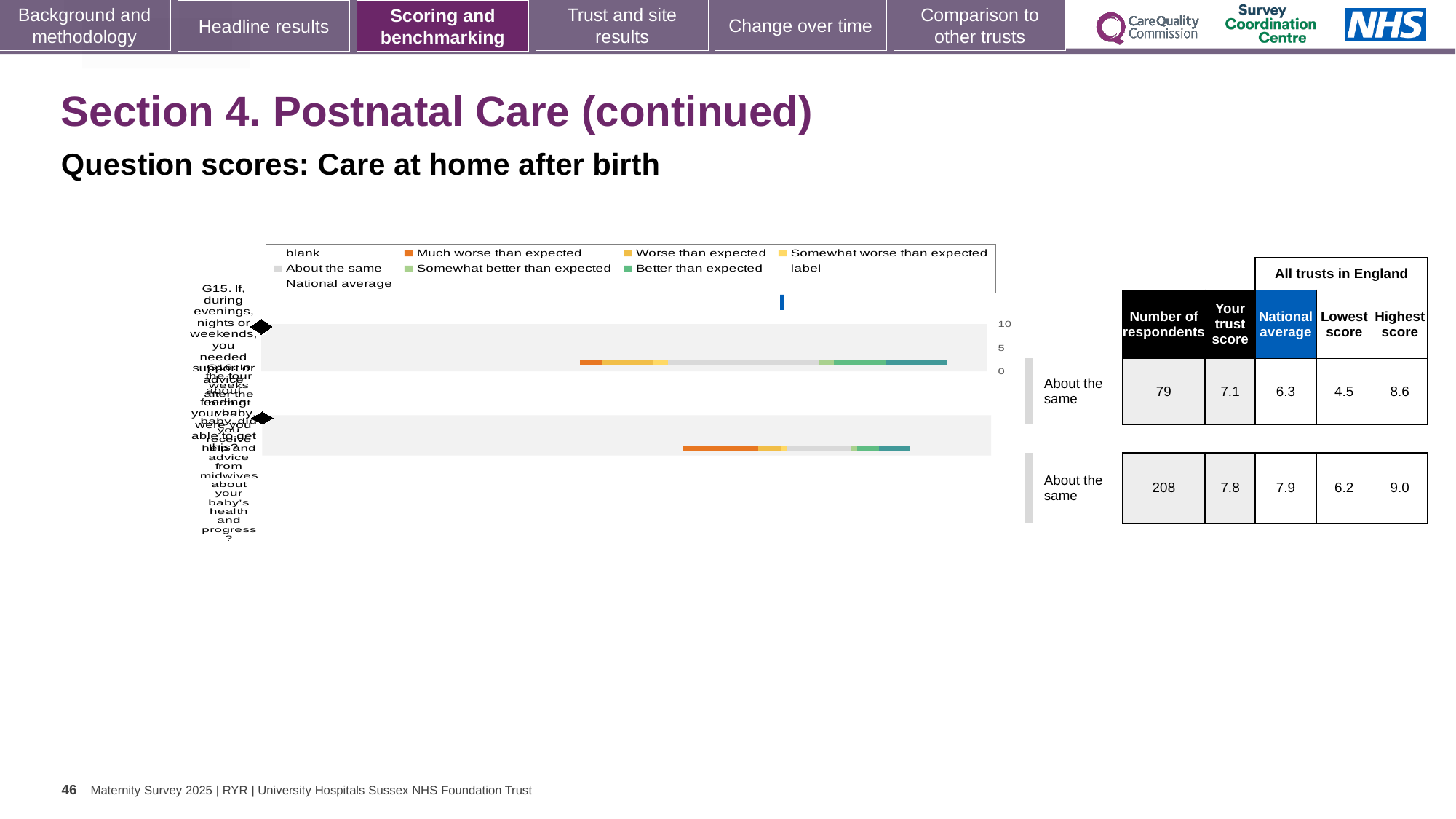
In the table beside the chart, what is the national average for the first row (G15)? 6.3 What benchmark category is shown next to both bars in the chart? About the same In the table beside the chart, which row has more respondents, the first (G15) or the second (G16)? the second (G16) What kind of chart is shown on the slide? bar chart In the table beside the chart, what is the difference between the highest score and the lowest score for the first row (G15)? 4.1 How many question bars are plotted in the chart? 2 In the table beside the chart, what is the number of respondents for the first row (G15)? 79 What does the blue vertical marker in the legend represent? National average In the table beside the chart, what is the highest score for the second row (G16)? 9.0 In the table beside the chart, what is the trust score for the second row (G16)? 7.8 What colour does the legend use for 'Much worse than expected'? orange In the table beside the chart, is the trust score for the second row (G16) greater or less than the national average? less